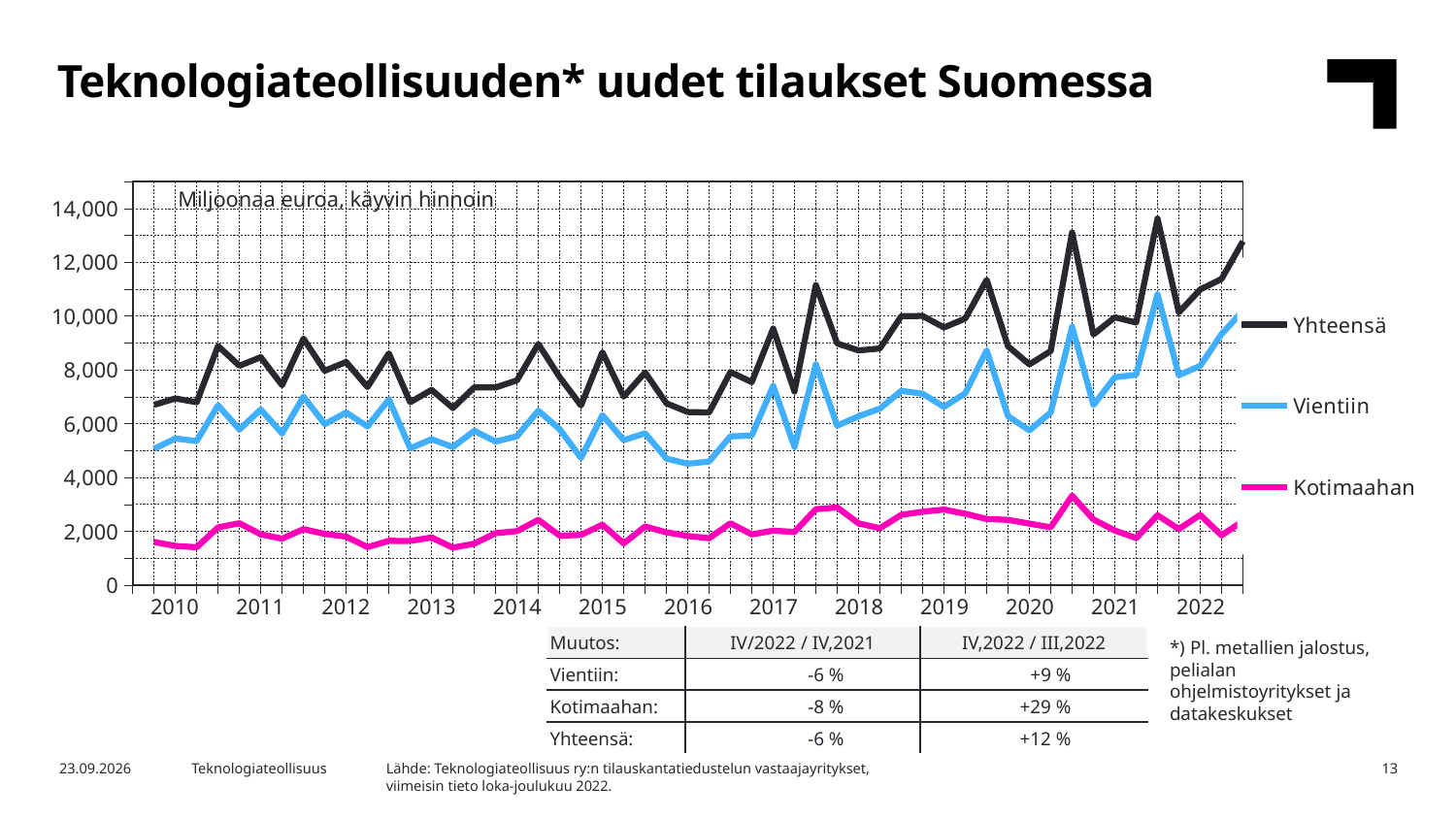
What kind of chart is shown on the slide? line chart Is the value for Vientiin at the start of 2016 greater or less than 6,000? less Is the highest Yhteensä peak in 2021 greater or less than 12,000? greater Overall, does the Yhteensä series rise or fall from 2010 to 2022? rise What are the three series named in the chart's legend? Yhteensä, Vientiin, Kotimaahan Is the value for Yhteensä at the end of 2022 greater or less than 12,000? greater What unit label is printed inside the chart area? Miljoonaa euroa, käyvin hinnoin Which series has the highest values across the whole chart? Yhteensä How many years are labelled on the x axis of the chart? 13 How many series does the chart's legend list? 3 Which series has the lowest values across the whole chart? Kotimaahan